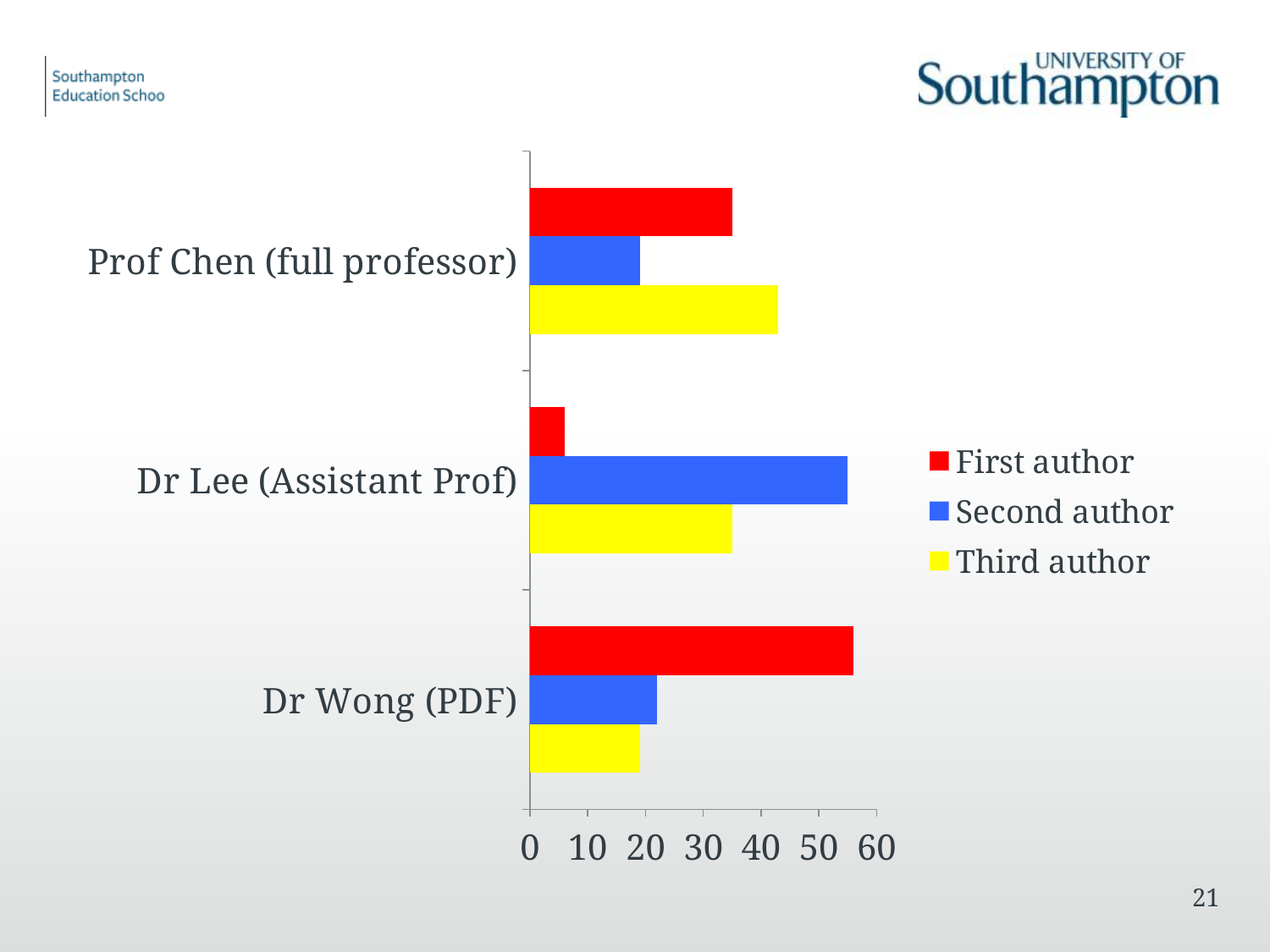
Which person has the highest First author value? Dr Wong (PDF) Which person has the highest Second author value? Dr Lee (Assistant Prof) Is the First author value for Dr Wong (PDF) greater or less than 50? greater Is the Third author value for Prof Chen (full professor) greater or less than 40? greater Which series is shown in yellow in the legend? Third author Which person has the lowest First author value? Dr Lee (Assistant Prof) What kind of chart is shown on the slide? bar chart Is the First author value for Dr Lee (Assistant Prof) greater or less than 10? less For Prof Chen (full professor), which is larger: the First author value or the Second author value? First author How many series does the legend list? 3 How many categories (people) are shown on the chart? 3